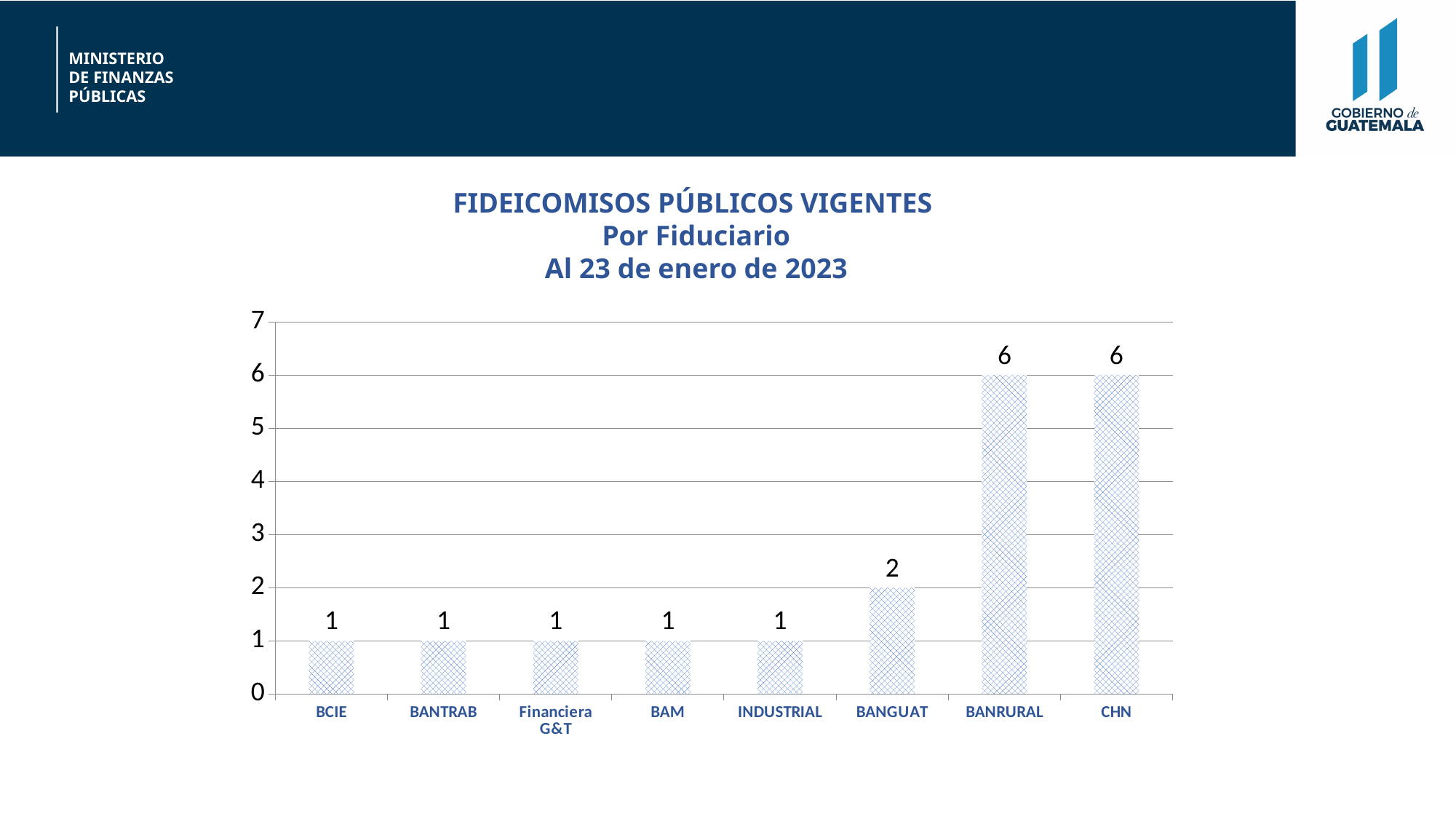
Which category has the lowest value that is not tied with others, i.e. which category has the second-highest value? BANGUAT What is the value for BANRURAL? 6 What is the value for BANGUAT? 2 What is the difference between the values for CHN and BANGUAT? 4 What is the date given in the chart title? Al 23 de enero de 2023 What kind of chart is shown on the slide? bar chart What is the value for INDUSTRIAL? 1 What is the difference between the values for BANGUAT and BAM? 1 Which is larger, the value for BANRURAL or the value for BANGUAT? BANRURAL Is the value for CHN greater or less than 4? greater How many categories are shown on the x axis? 8 What is the value for Financiera G&T? 1